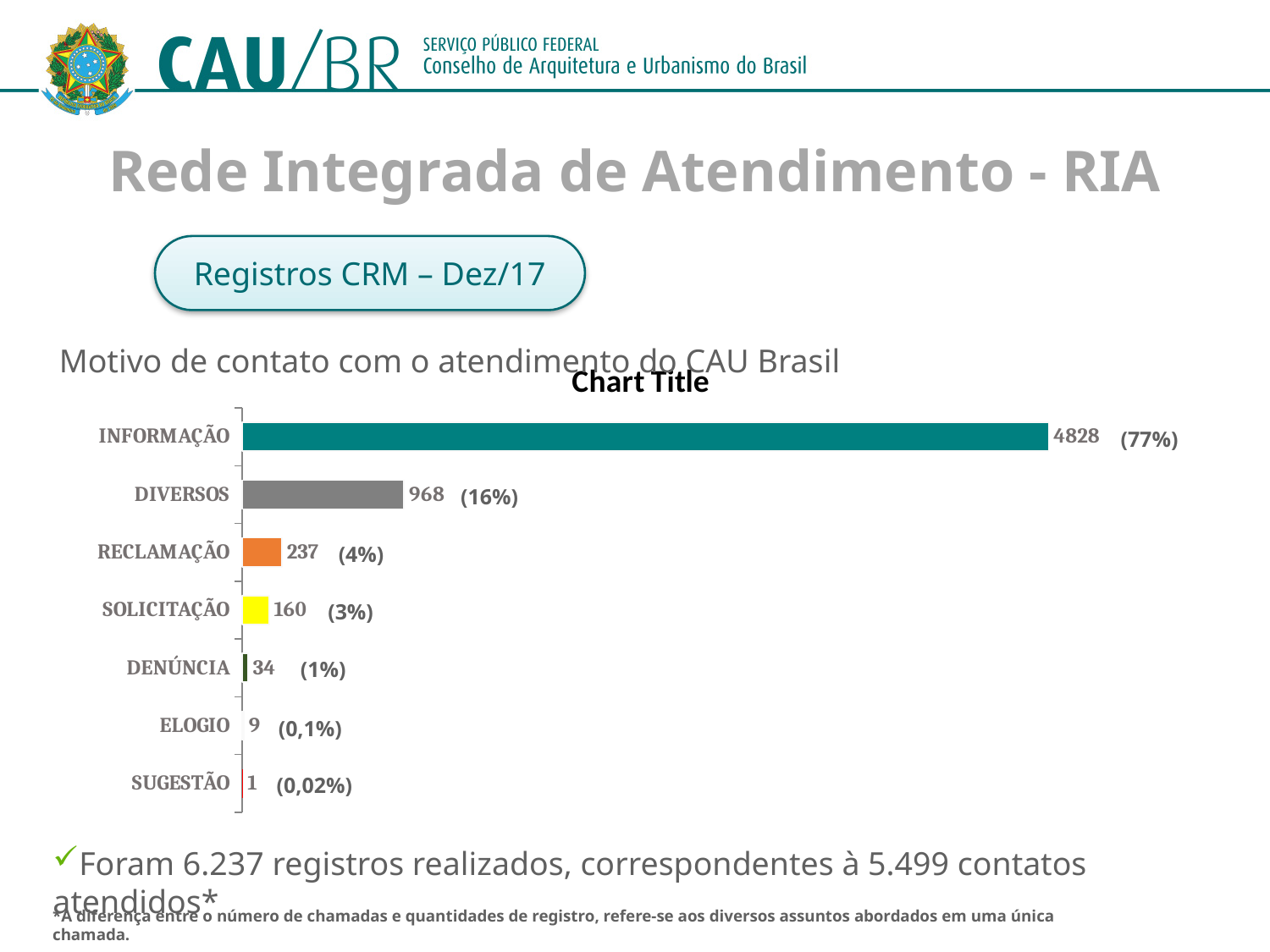
What is the value for DENÚNCIA? 34 What is the value for INFORMAÇÃO? 4828 What is the difference between the values for INFORMAÇÃO and DIVERSOS? 3860 Which is larger, the value for RECLAMAÇÃO or the value for SOLICITAÇÃO? RECLAMAÇÃO What is the value for SOLICITAÇÃO? 160 Which category has the highest value? INFORMAÇÃO What kind of chart is shown on the slide? bar chart Which category has the lowest value? SUGESTÃO How many categories are shown in the chart? 7 What percentage is shown next to the bar for DIVERSOS? (16%) What is the value for DIVERSOS? 968 What is the value for RECLAMAÇÃO? 237